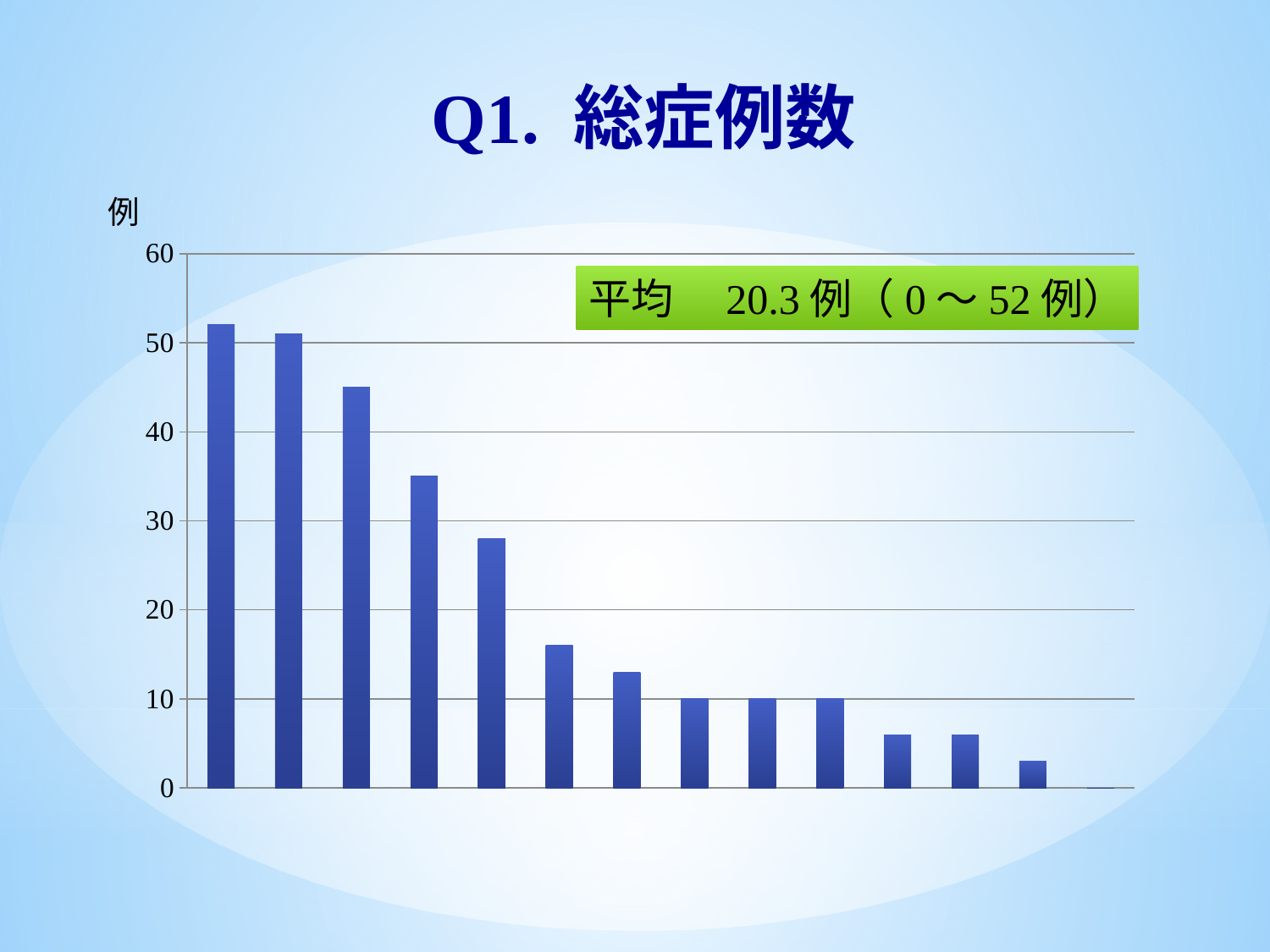
Is the value of the fifth bar from the left greater or less than 30? less Do the bar values rise or fall from left to right across the chart? fall What is the highest value shown on the vertical axis? 60 What unit is shown at the top of the vertical axis? 例 According to the annotation on the chart, what is the maximum number of cases (the value of the tallest bar)? 52 例 Which is larger, the value of the second bar from the left or the value of the fourth bar from the left? the second bar What kind of chart is shown on the slide? bar chart Is the value of the fourth bar from the left greater or less than 40? less Is the value of the sixth bar from the left greater or less than 20? less What is the title of the chart? Q1. 総症例数